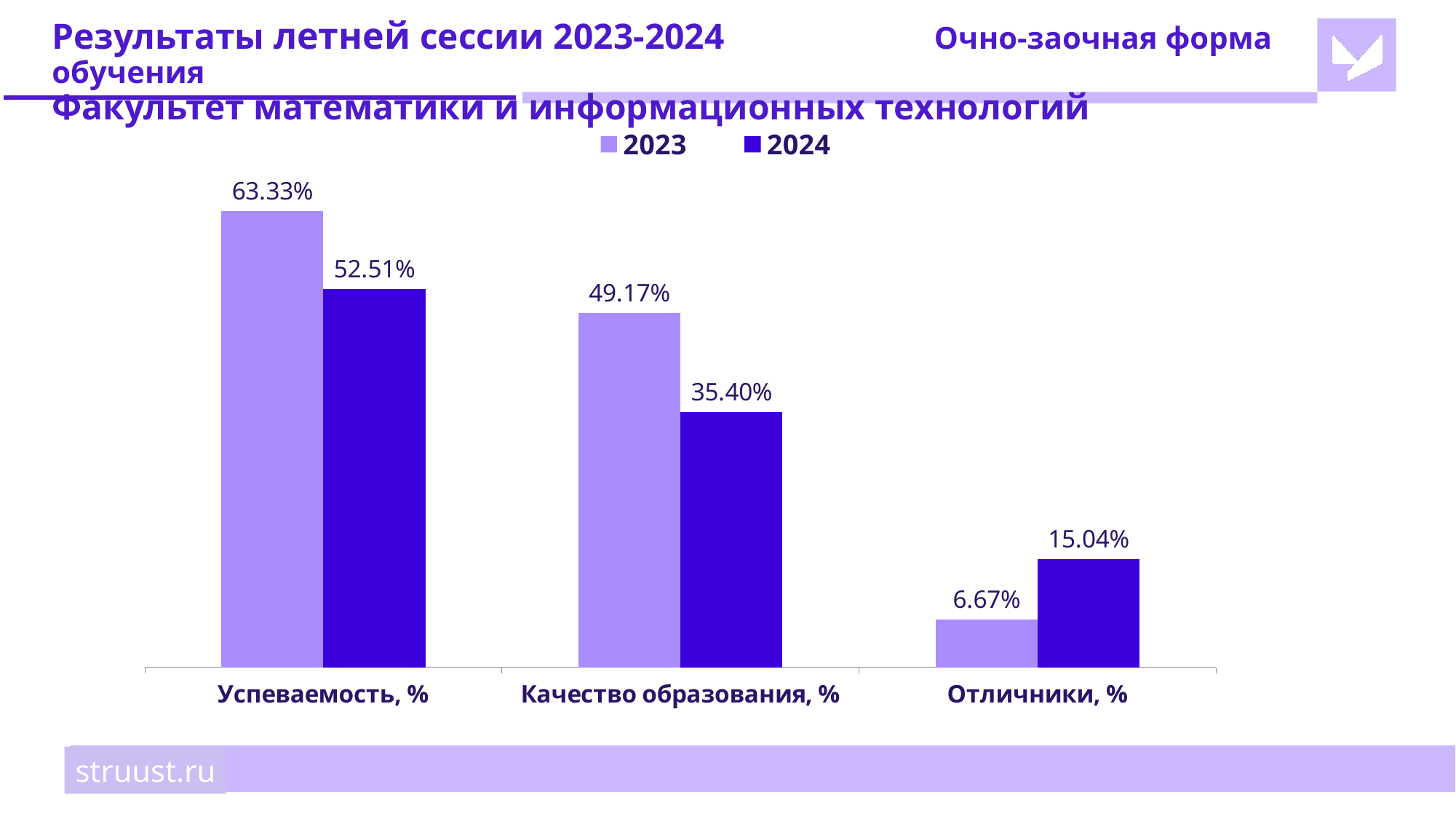
How many series does the legend list? 2 What is the difference between the 2023 and 2024 values for Успеваемость, %? 10.82% What is the 2024 value for Отличники, %? 15.04% Which category has the lowest 2024 value? Отличники, % How many categories are shown on the x axis? 3 For Отличники, %, which year has the larger value, 2023 or 2024? 2024 Which category has the highest 2023 value? Успеваемость, % What is the 2024 value for Качество образования, %? 35.40% What is the 2023 value for Отличники, %? 6.67% What is the 2023 value for Успеваемость, %? 63.33% What kind of chart is shown on the slide? Bar chart What is the difference between the 2023 and 2024 values for Качество образования, %? 13.77%